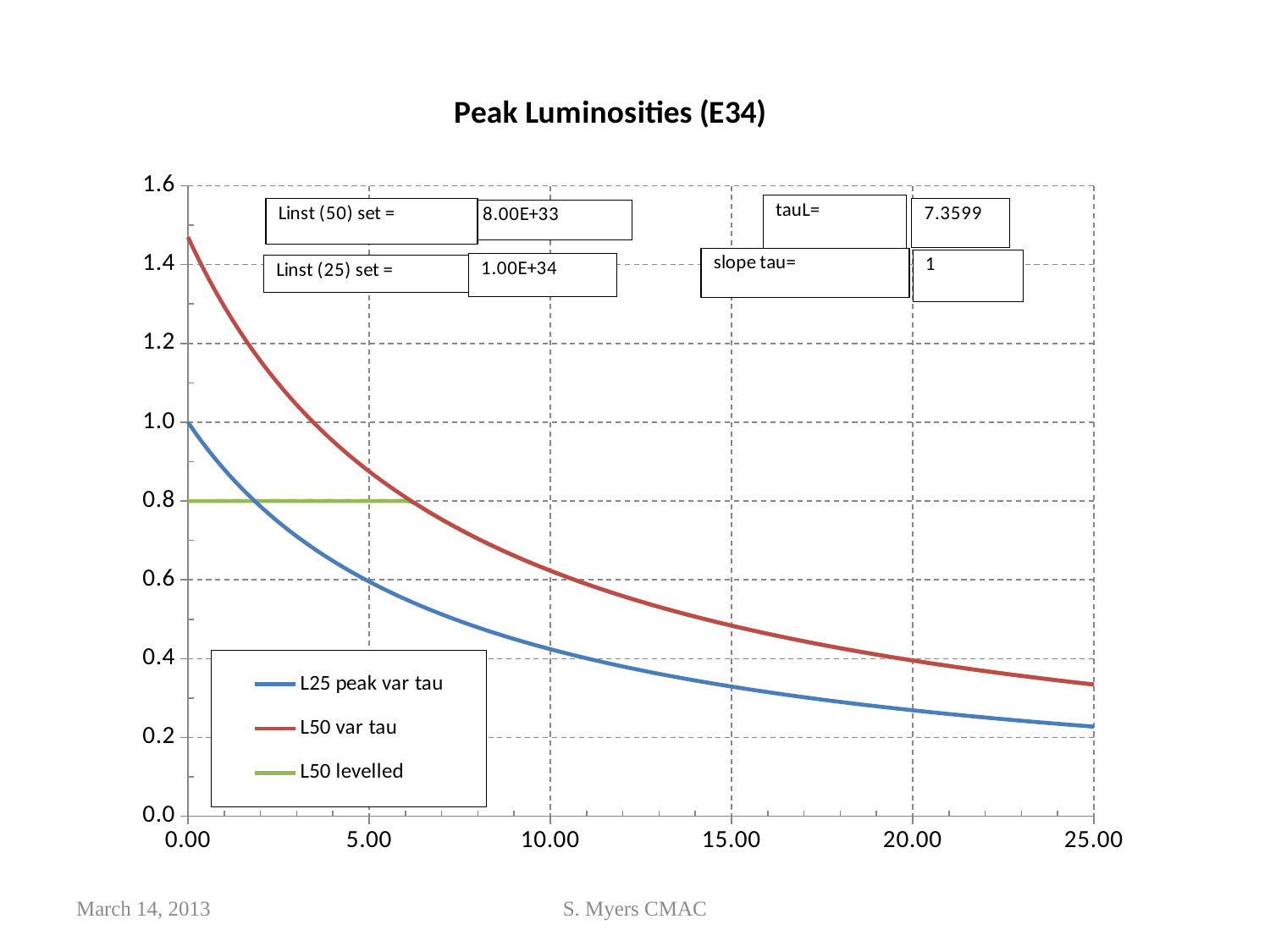
At what constant value does the L50 levelled line sit? 0.8 Does the L50 var tau series rise or fall as x increases? fall Which series is drawn in green in the legend? L50 levelled How many series does the legend list? 3 Does the L25 peak var tau series rise or fall as x increases from 0.00 to 25.00? fall Is the value of L50 var tau at x = 25.00 greater or less than 0.4? less Is the value of L50 var tau at x = 0.00 greater or less than 1.4? greater What is the title of the chart? Peak Luminosities (E34) What is the value of L25 peak var tau at x = 0.00? 1.0 Is the value of L25 peak var tau at x = 15.00 greater or less than 0.4? less What kind of chart is shown on the slide? line chart At x = 10.00, which series has the higher value, L50 var tau or L25 peak var tau? L50 var tau